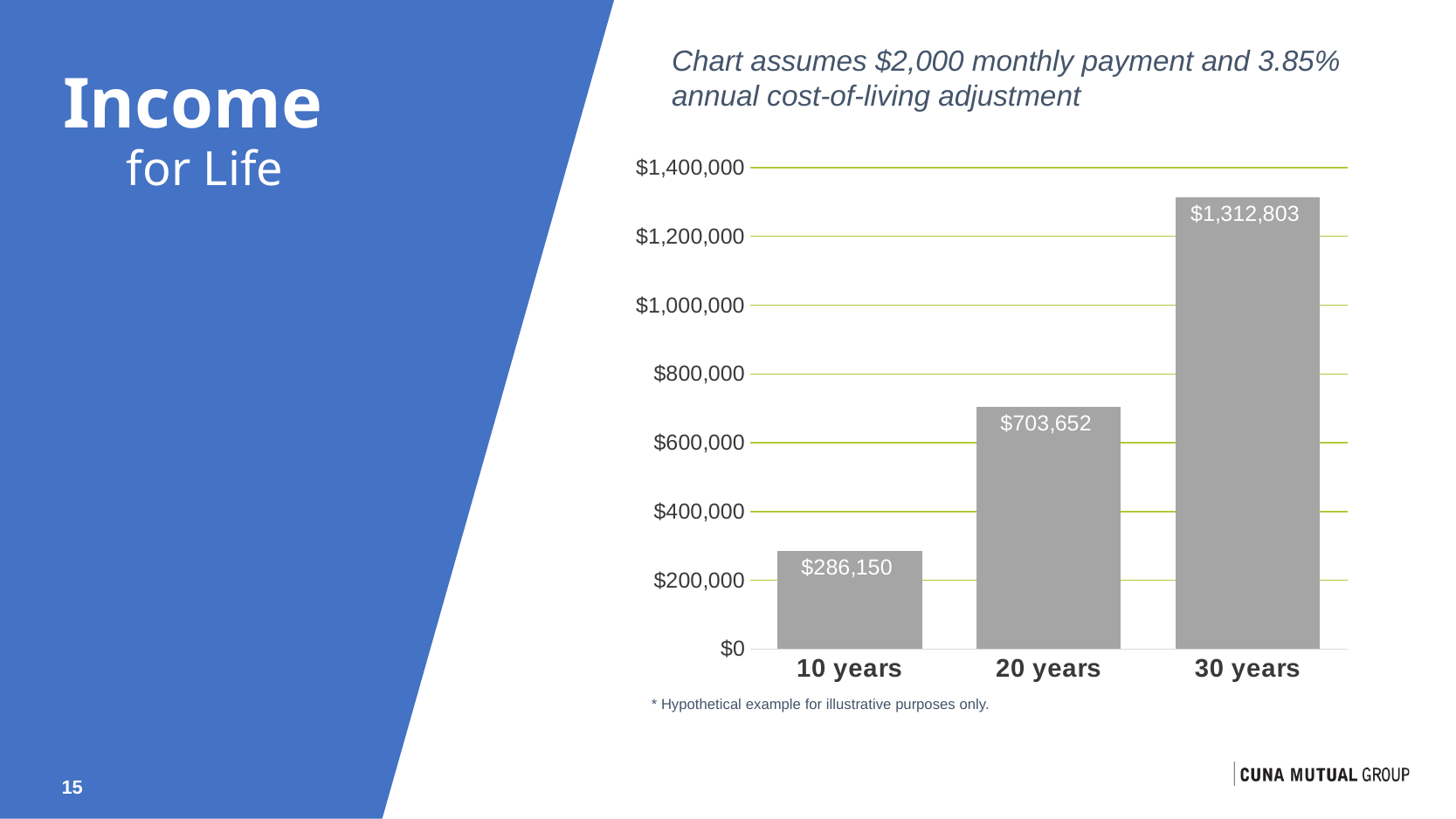
What is the value shown for 10 years? $286,150 Is the value for 30 years greater or less than $1,200,000? greater What kind of chart is shown on the slide? bar chart Which category has the lowest value? 10 years Which is larger, the value for 20 years or the value for 30 years? 30 years What is the value shown for 20 years? $703,652 What is the difference between the values for 20 years and 10 years? $417,502 Which category has the highest value? 30 years What is the value shown for 30 years? $1,312,803 How many categories are shown on the x axis? 3 What is the difference between the values for 30 years and 20 years? $609,151 Do the values rise or fall from 10 years to 30 years? rise